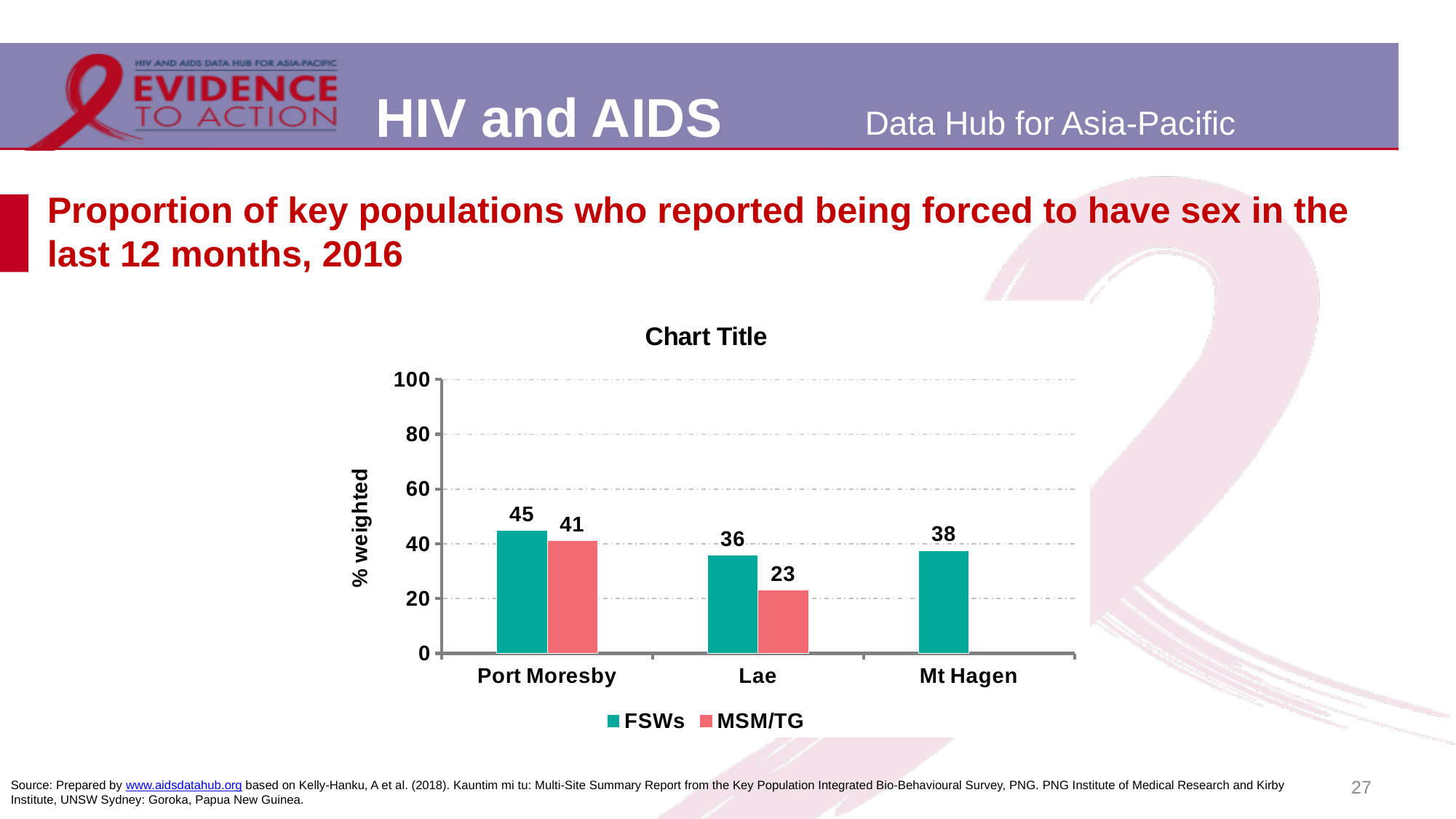
Which is larger in Port Moresby, the FSWs value or the MSM/TG value? FSWs Which city has the highest value for FSWs? Port Moresby What is the value for MSM/TG in Lae? 23 What kind of chart is shown on the slide? Bar chart What is the difference between the FSWs values for Port Moresby and Mt Hagen? 7 How many cities are shown on the x axis? 3 Which city has the lowest value for FSWs? Lae What is the value for FSWs in Port Moresby? 45 Is the value for MSM/TG in Port Moresby greater or less than 60? less What is the difference between the FSWs and MSM/TG values in Lae? 13 What is the value for FSWs in Mt Hagen? 38 How many series does the legend list? 2